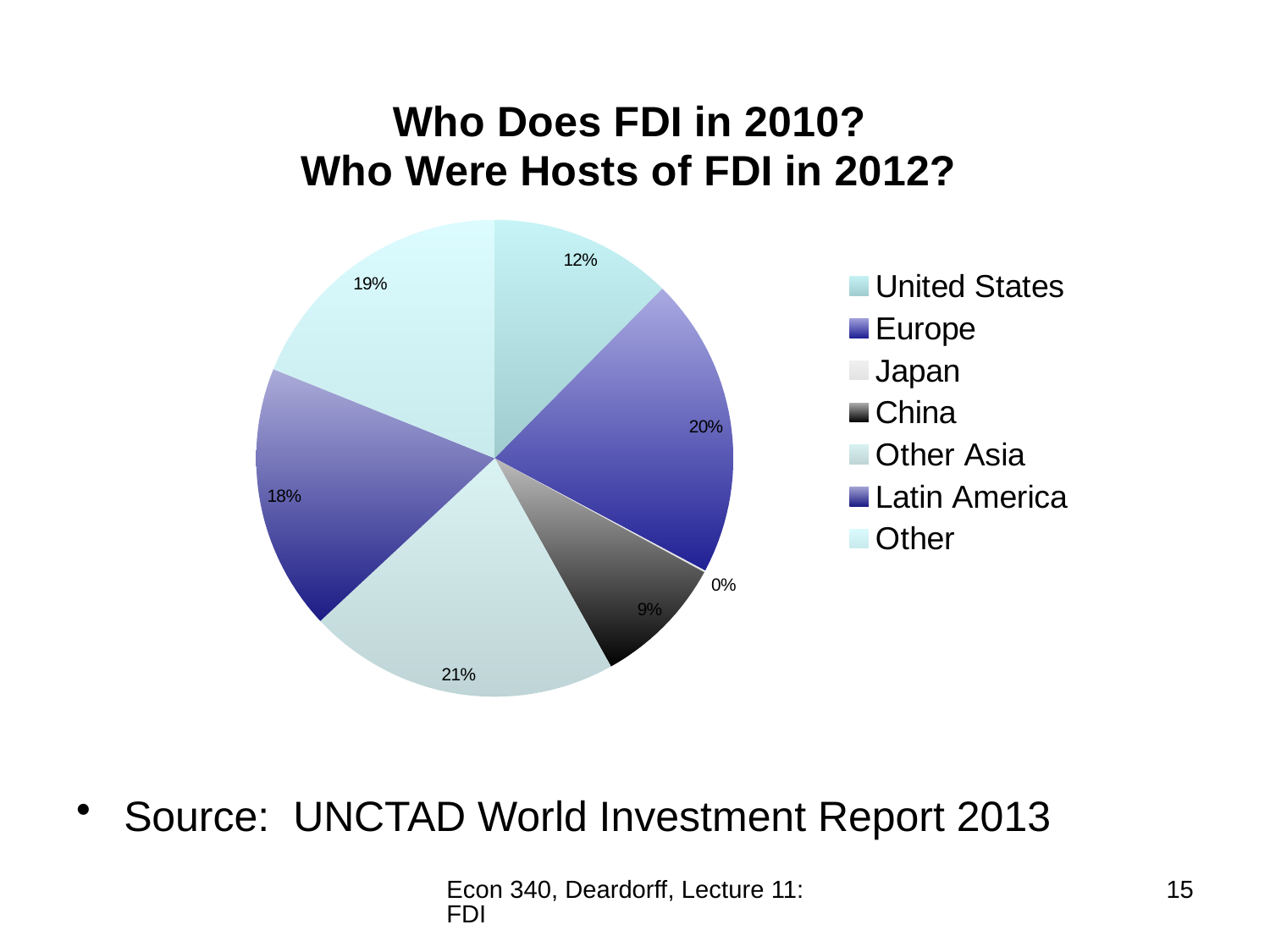
What share of the pie does the United States slice represent? 12% What is the source cited for the chart data? UNCTAD World Investment Report 2013 Which category has the smallest slice of the pie? Japan Which category has the largest slice of the pie? Other Asia What is the difference in percentage points between Europe and the United States? 8 What kind of chart is shown on the slide? Pie chart How many categories does the legend list? 7 What percentage is shown for China? 9% What percentage is shown for Latin America? 18% What percentage is shown for Europe? 20% Which is larger, the share for Other or the share for Latin America? Other What percentage is shown for Other Asia? 21%